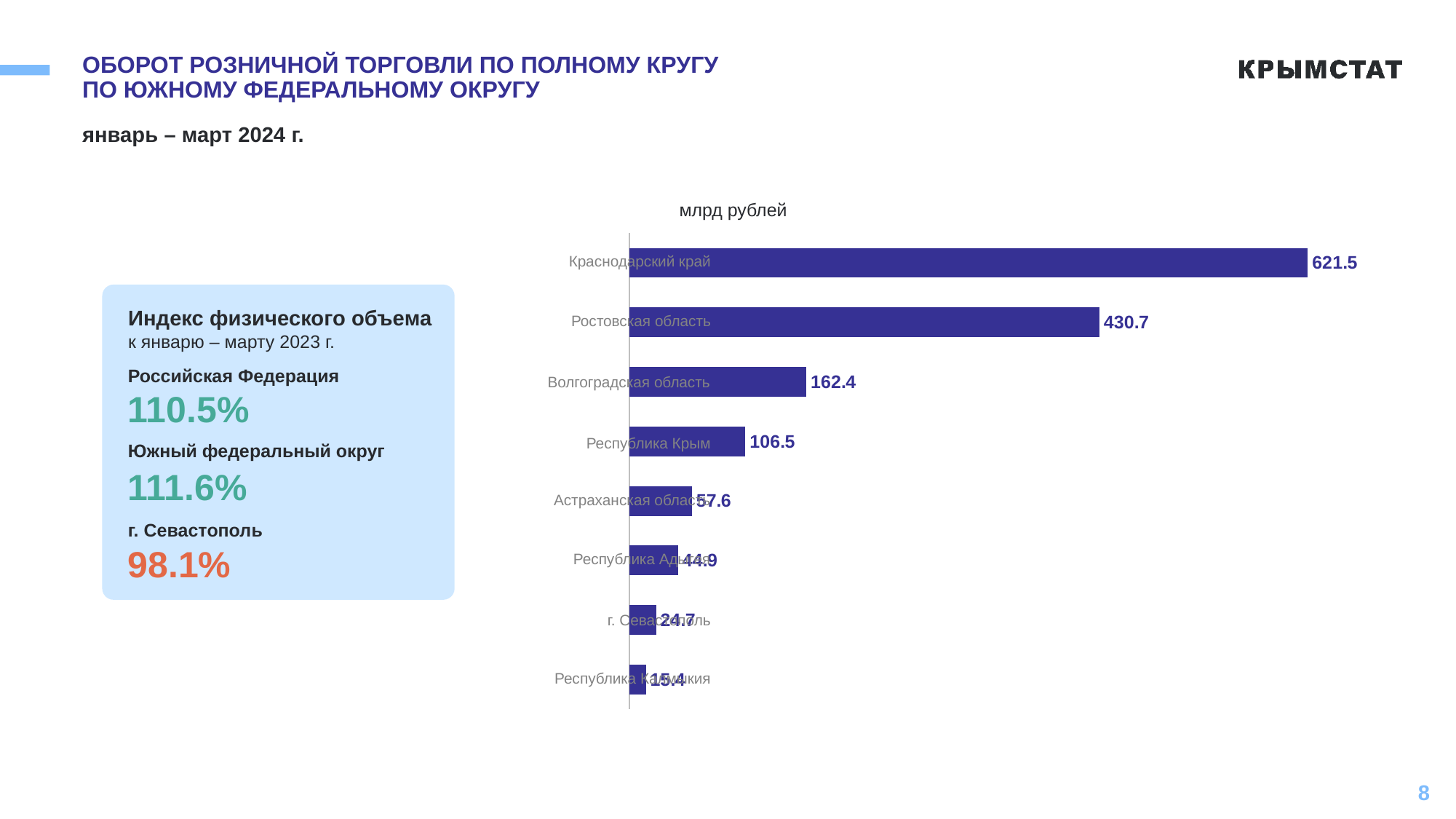
What unit of measurement is indicated above the chart? млрд рублей Which region has the highest retail trade turnover on the chart? Краснодарский край What is the value shown for Волгоградская область? 162.4 What is the value shown for Республика Крым? 106.5 What is the difference between the values for Республика Крым and г. Севастополь? 81.8 How many regions are shown on the chart? 8 What type of chart is shown on the slide? Bar chart What is the difference between the values for Краснодарский край and Ростовская область? 190.8 Which has a larger value: Волгоградская область or Республика Крым? Волгоградская область Which region has the lowest retail trade turnover on the chart? Республика Калмыкия What is the value shown for Ростовская область? 430.7 What is the retail trade turnover for Краснодарский край, in млрд рублей? 621.5